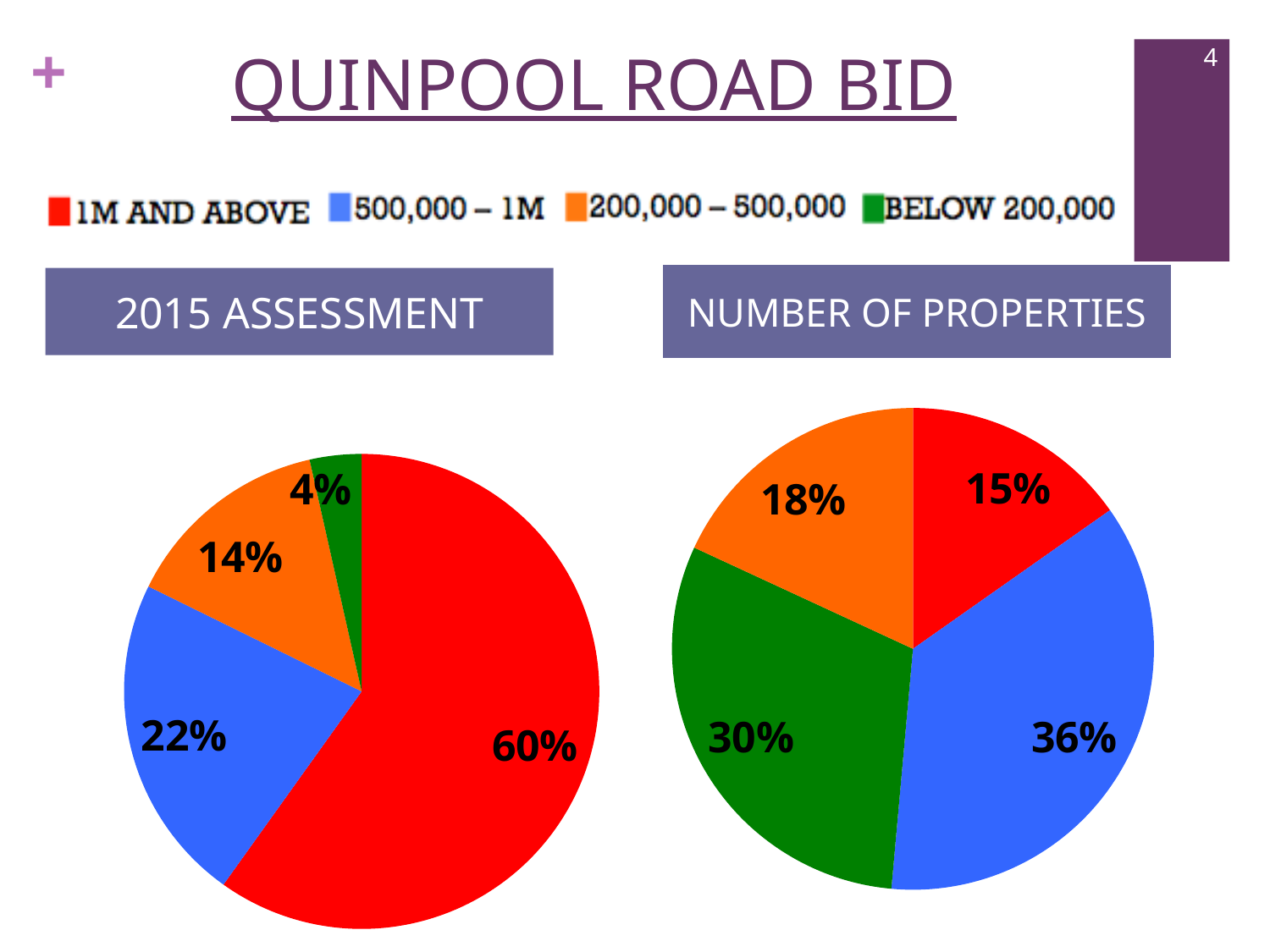
In the NUMBER OF PROPERTIES pie chart, which category has the largest share? 500,000 – 1M In the 2015 ASSESSMENT pie chart, what share does the BELOW 200,000 category have? 4% In the NUMBER OF PROPERTIES pie chart, which category has the smallest share? 1M AND ABOVE In the 2015 ASSESSMENT pie chart, which category has the largest share? 1M AND ABOVE In the NUMBER OF PROPERTIES pie chart, what is the difference between the BELOW 200,000 share and the 1M AND ABOVE share? 15% Which is larger: the BELOW 200,000 share in the 2015 ASSESSMENT chart or the BELOW 200,000 share in the NUMBER OF PROPERTIES chart? NUMBER OF PROPERTIES In the 2015 ASSESSMENT pie chart, what is the difference between the 1M AND ABOVE share and the 500,000 – 1M share? 38% How many categories does the legend list? 4 What type of chart is used for the 2015 ASSESSMENT data? Pie chart In the 2015 ASSESSMENT pie chart, what share does the 1M AND ABOVE category have? 60% In the NUMBER OF PROPERTIES pie chart, what share does the 500,000 – 1M category have? 36% In the NUMBER OF PROPERTIES pie chart, what share does the 200,000 – 500,000 category have? 18%